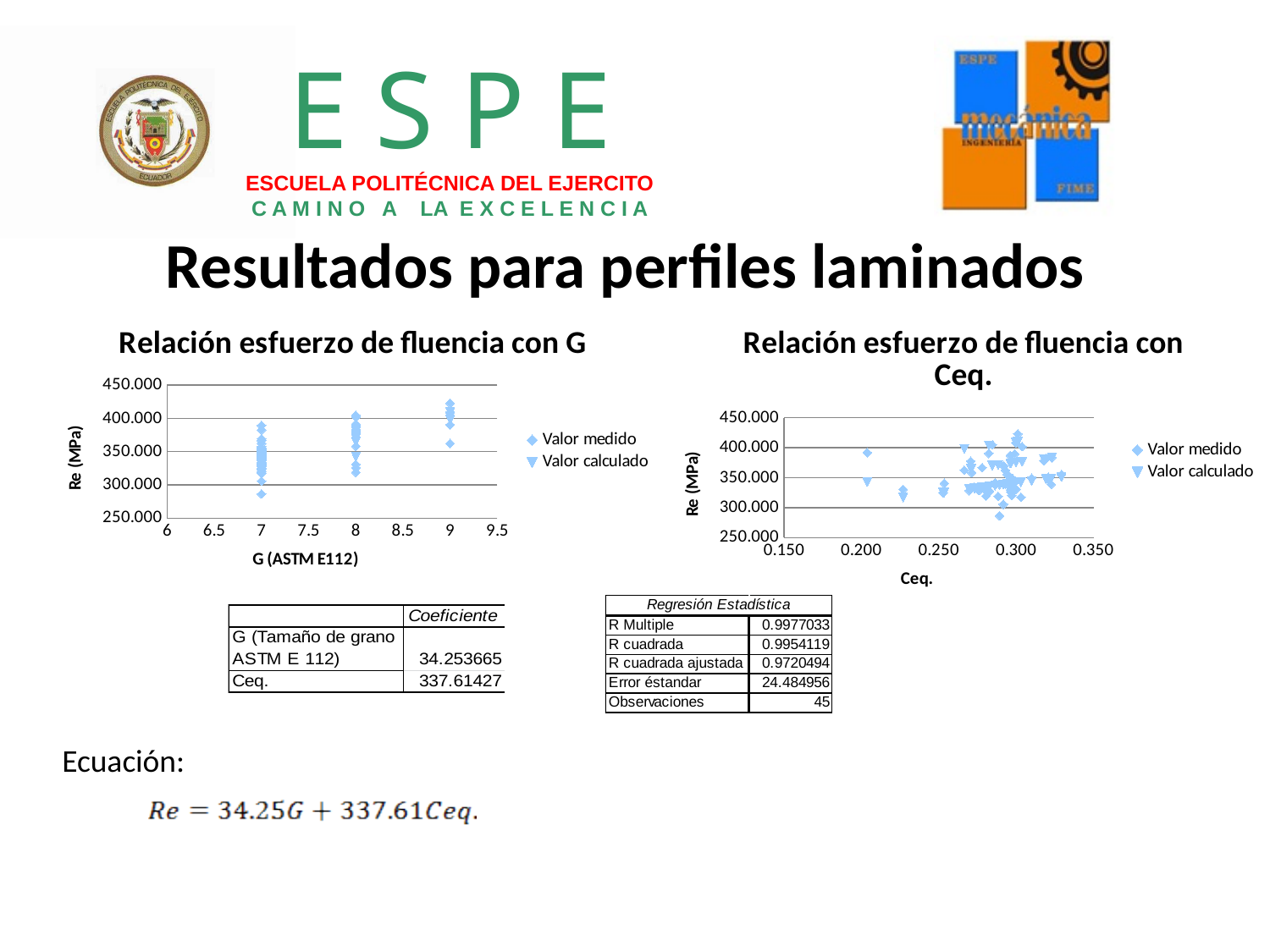
What is the x-axis label of the chart "Relación esfuerzo de fluencia con G"? G (ASTM E112) How many series does the legend of the chart "Relación esfuerzo de fluencia con G" list? 2 How many series does the legend of the chart "Relación esfuerzo de fluencia con Ceq." list? 2 In the chart "Relación esfuerzo de fluencia con Ceq.", is the lowest plotted point greater or less than 300? less In the chart "Relación esfuerzo de fluencia con G", what are the two series named in the legend? Valor medido, Valor calculado What kind of chart is the chart titled "Relación esfuerzo de fluencia con G"? scatter chart In the chart "Relación esfuerzo de fluencia con G", is the lowest point at G = 7 greater or less than 300? less What kind of chart is the chart titled "Relación esfuerzo de fluencia con Ceq."? scatter chart In the chart "Relación esfuerzo de fluencia con G", is the highest point at G = 9 greater or less than 400? greater In the chart "Relación esfuerzo de fluencia con G", do the Re values generally rise or fall as G increases from 7 to 9? rise In the chart "Relación esfuerzo de fluencia con G", at how many distinct G values are points plotted? 3